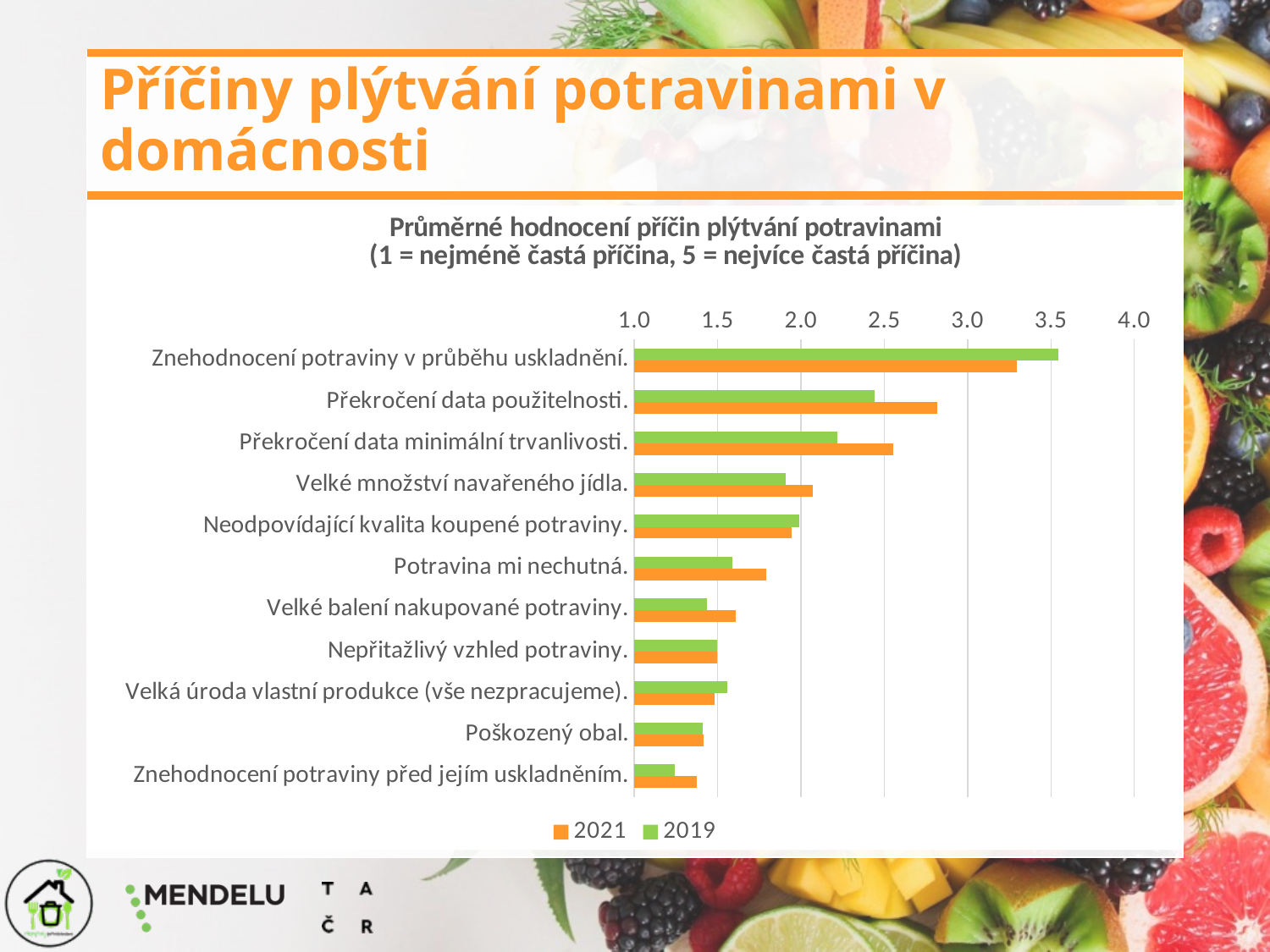
How many categories (causes) are plotted in the chart? 11 How many series does the legend list? 2 For 'Překročení data použitelnosti.', which series has the larger value, 2021 or 2019? 2021 Is the 2021 value for 'Překročení data použitelnosti.' greater or less than 2.5? greater What kind of chart is shown on the slide? bar chart Which colour represents the 2019 series in the chart? green Which cause has the lowest value for the 2019 series? Znehodnocení potraviny před jejím uskladněním. Is the 2019 value for 'Poškozený obal.' greater or less than 1.5? less Is the 2021 value for 'Znehodnocení potraviny v průběhu uskladnění.' greater or less than 3.0? greater Which cause has the highest value for the 2019 series? Znehodnocení potraviny v průběhu uskladnění. For 'Znehodnocení potraviny v průběhu uskladnění.', which series has the larger value, 2021 or 2019? 2019